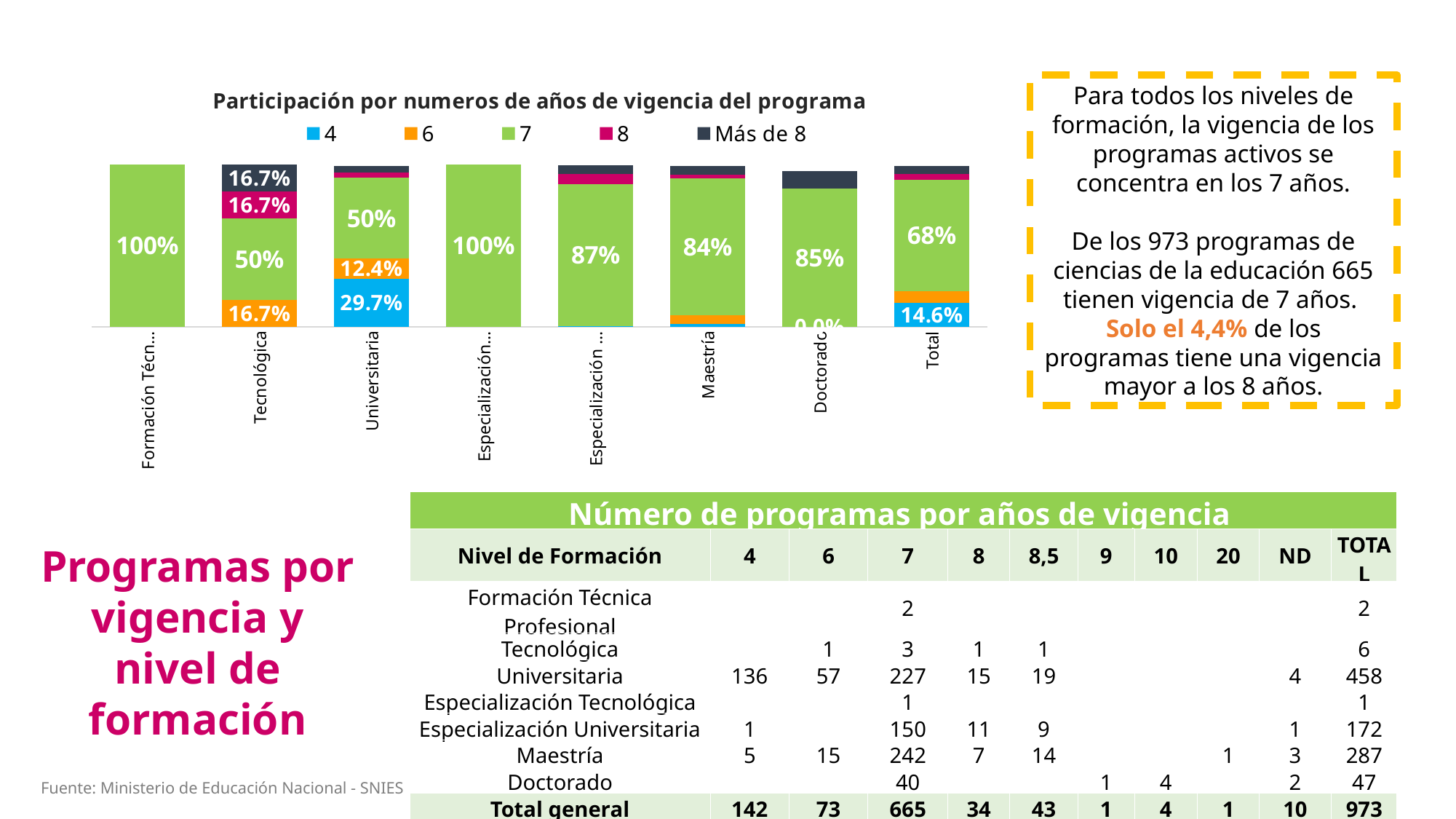
What is the difference between the '7' series value for Total and the '4' series value for Total? 53.4% What is the value of the '4' series for Universitaria? 29.7% What is the value of the '7' series for Maestría? 84% What is the value of the '4' series for Total? 14.6% What is the value of the '7' series for Doctorado? 85% What is the value of the '6' series for Tecnológica? 16.7% Which is larger, the '7' series value for Maestría or for Doctorado? Doctorado How many bars (categories) are plotted in the chart? 8 What type of chart is shown on the slide? Stacked bar chart What is the title of the chart? Participación por numeros de años de vigencia del programa What is the value of the '6' series for Universitaria? 12.4% How many series does the chart legend list? 5